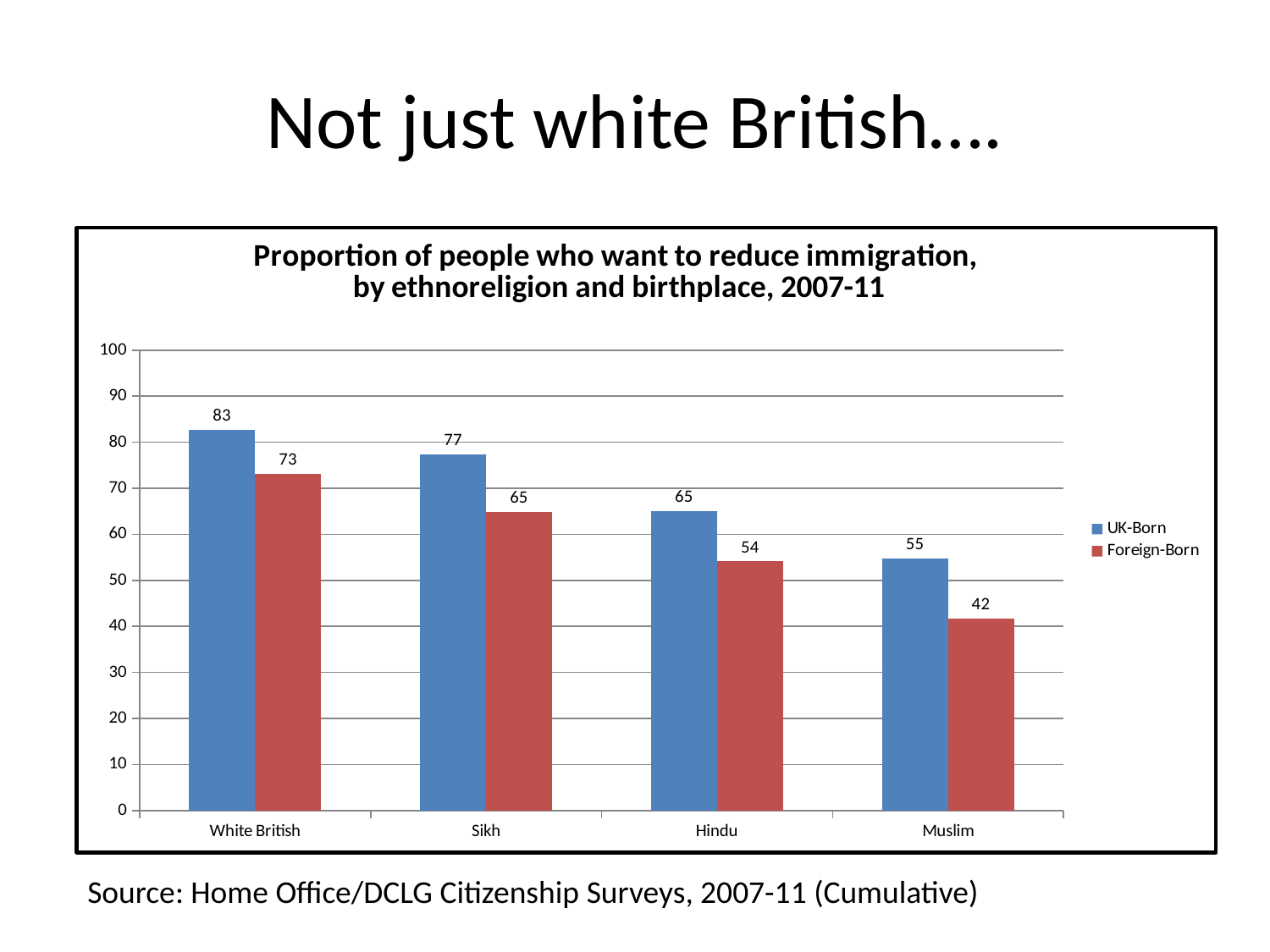
What kind of chart is shown? bar chart Which category has the highest UK-Born value? White British What is the difference between the UK-Born and Foreign-Born values for Hindu? 11 How many series does the legend list? 2 What is the Foreign-Born value for Muslim? 42 How many categories are shown on the x axis? 4 Do the UK-Born values rise or fall from White British to Muslim? fall Is the Foreign-Born value for White British greater or less than 70? greater What is the UK-Born value for White British? 83 Which is larger, the UK-Born value for Sikh or the UK-Born value for Muslim? Sikh What is the Foreign-Born value for Sikh? 65 Which category has the lowest Foreign-Born value? Muslim